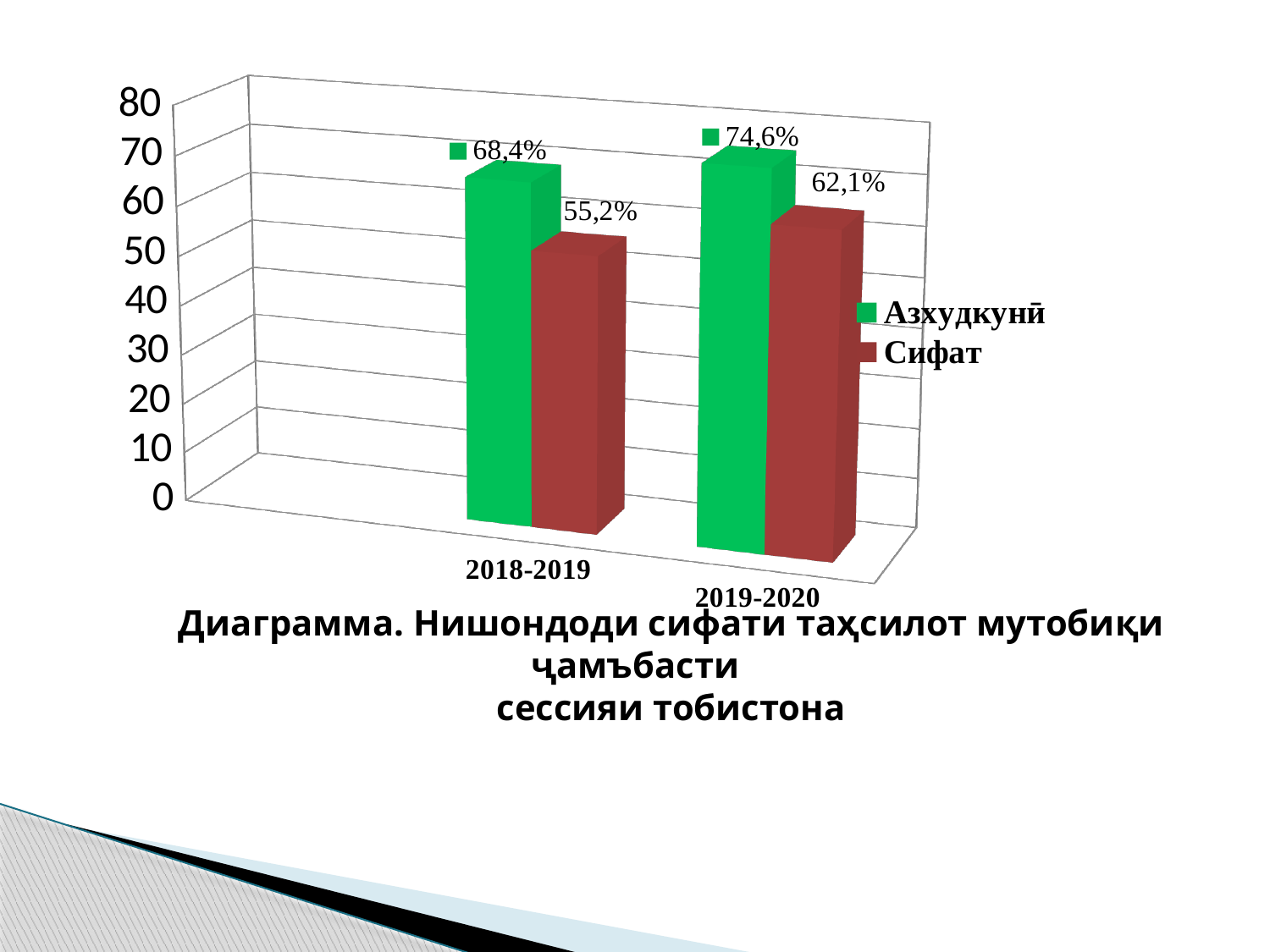
What is the value for Азхудкунӣ in 2018-2019? 68,4% Which bar has the lowest value on the chart? Сифат in 2018-2019 What kind of chart is shown on the slide? Bar chart How many series does the legend list? 2 What is the value for Сифат in 2019-2020? 62,1% What is the value for Сифат in 2018-2019? 55,2% What is the difference between Азхудкунӣ and Сифат in 2018-2019? 13,2% What is the value for Азхудкунӣ in 2019-2020? 74,6% Which bar has the highest value on the chart? Азхудкунӣ in 2019-2020 By how much did Азхудкунӣ increase from 2018-2019 to 2019-2020? 6,2% Which is larger in 2019-2020, Азхудкунӣ or Сифат? Азхудкунӣ Does the Сифат value rise or fall from 2018-2019 to 2019-2020? Rise